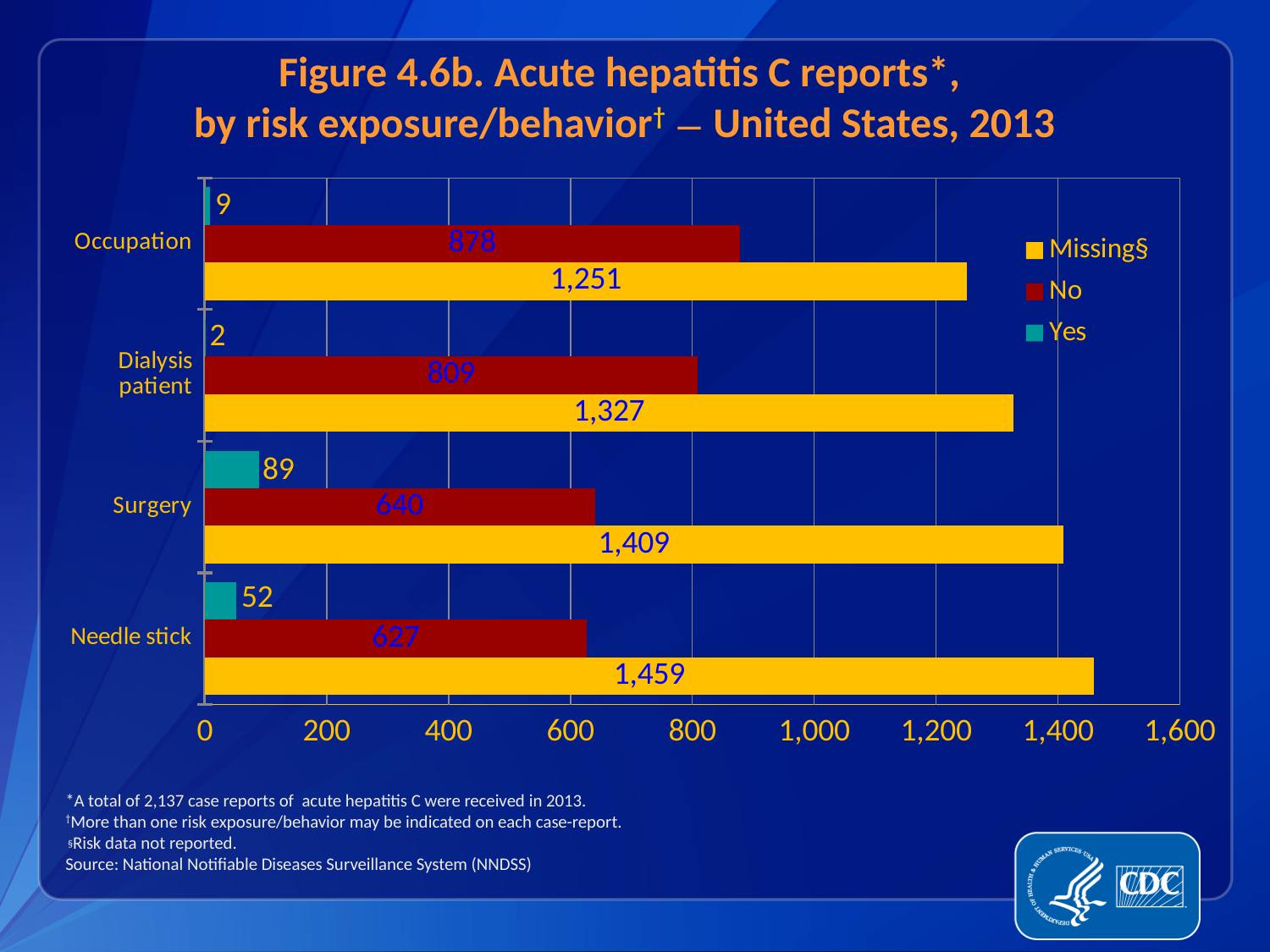
Is the No value for Dialysis patient greater or less than 1,000? less Which is larger, the Missing value for Surgery or the Missing value for Dialysis patient? Surgery What is the value for Yes in the Surgery category? 89 How many risk exposure/behavior categories are shown on the chart? 4 What is the value for No in the Occupation category? 878 What is the difference between the No values for Occupation and Needle stick? 251 Which category has the highest Missing value? Needle stick What is the value for Missing in the Needle stick category? 1,459 What is the value for Yes in the Dialysis patient category? 2 Which category has the lowest Yes value? Dialysis patient What kind of chart is shown on the slide? bar chart How many series does the legend list? 3